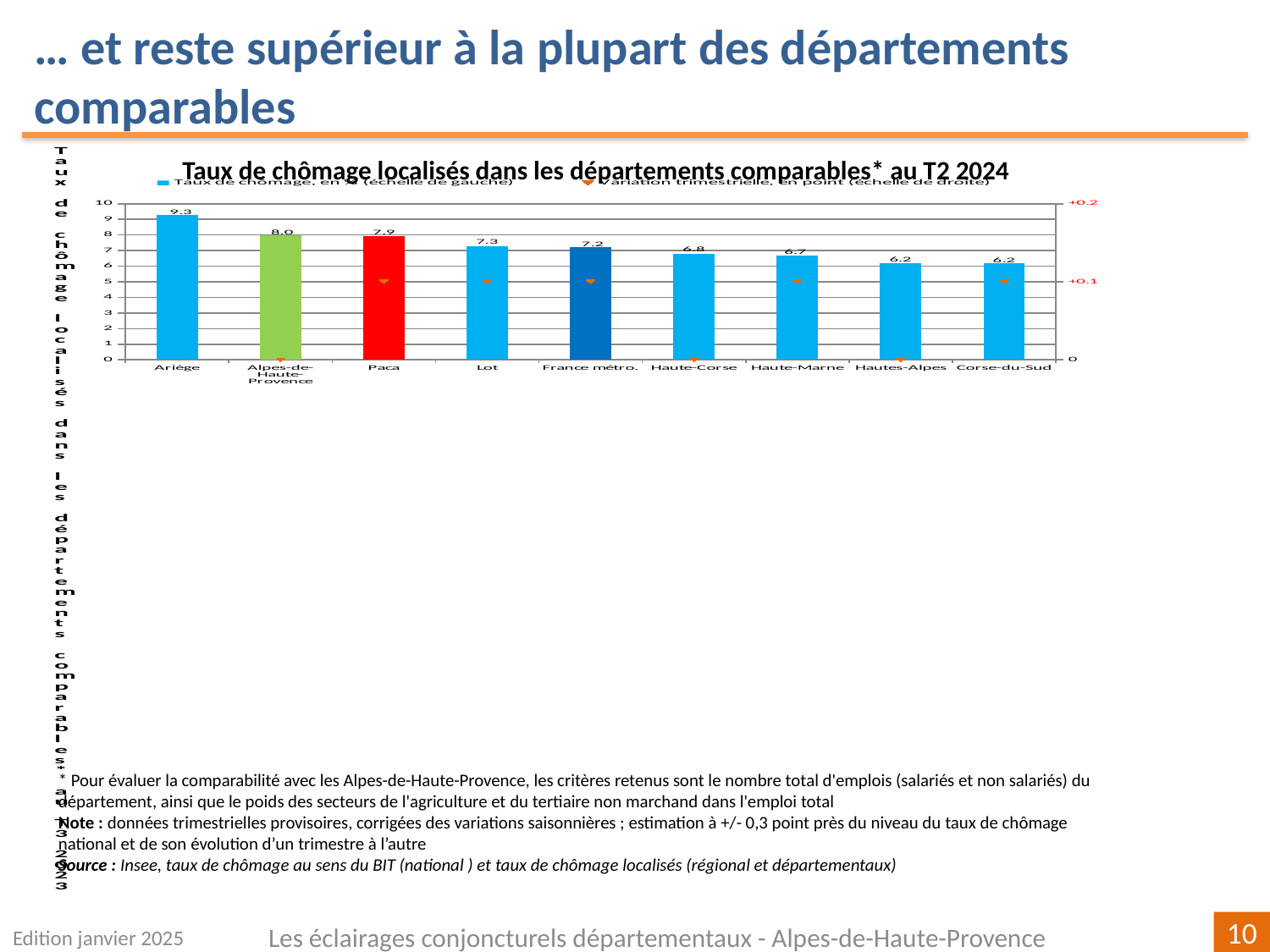
Which has a higher unemployment rate, Haute-Corse or Haute-Marne? Haute-Corse What is the unemployment rate shown for Lot? 7.3 What is the difference between the unemployment rates of Ariège and Alpes-de-Haute-Provence? 1.3 What type of chart is used to show the unemployment rates? Bar chart What is the unemployment rate shown for Alpes-de-Haute-Provence? 8.0 What is the unemployment rate shown for France métro.? 7.2 How many series does the legend list? 2 Do the unemployment rate bars rise or fall from left to right across the chart? Fall What is the unemployment rate shown for Ariège? 9.3 How many departments or areas are shown as bars on the chart? 9 What is the difference between the unemployment rates of Alpes-de-Haute-Provence and France métro.? 0.8 Which department has the highest unemployment rate on the chart? Ariège